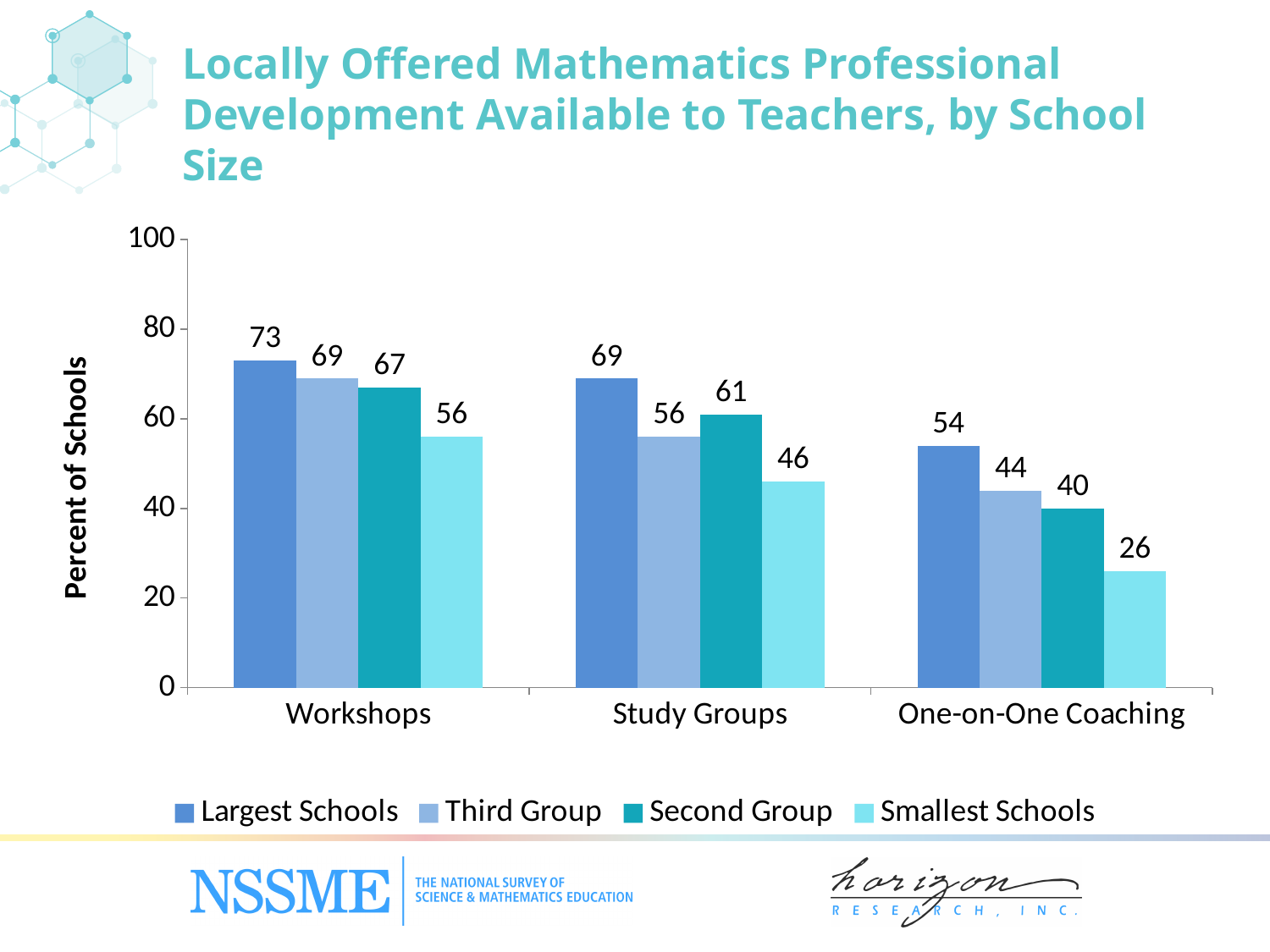
How many series does the legend list? 4 Which is larger in the Study Groups category: Third Group or Second Group? Second Group What is the value for Largest Schools in the Workshops category? 73 Which school size group has the highest value in the Study Groups category? Largest Schools What kind of chart is shown on the slide? Bar chart What is the label on the y axis? Percent of Schools Do the values for Largest Schools rise or fall from Workshops to One-on-One Coaching? Fall What is the value for Second Group in the Study Groups category? 61 How many categories are shown on the x axis? 3 What is the difference between Largest Schools and Smallest Schools in the One-on-One Coaching category? 28 Which category has the lowest value for Smallest Schools? One-on-One Coaching What is the value for Smallest Schools in the One-on-One Coaching category? 26